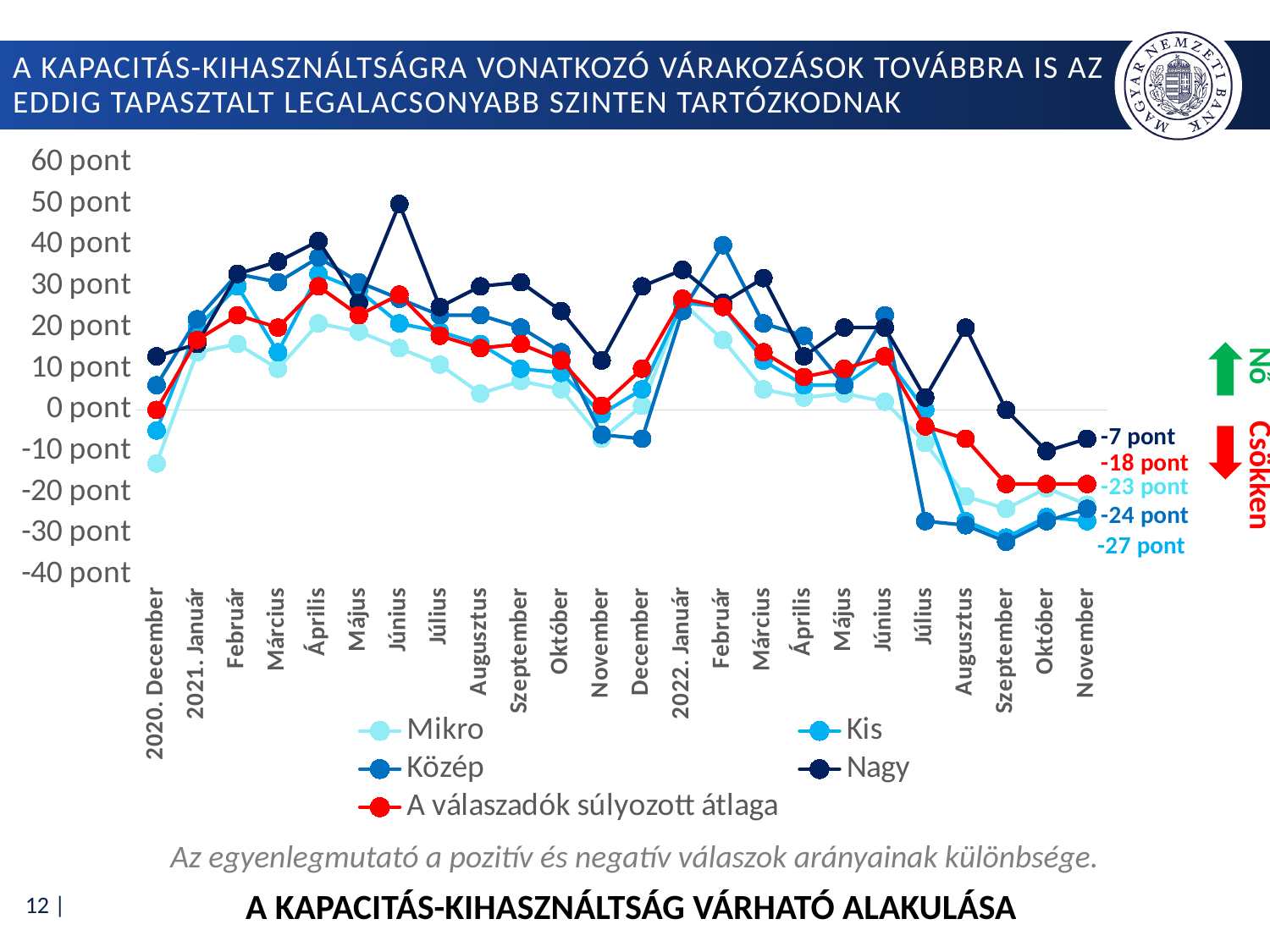
What is the value for Kis at the last point (November 2022)? -27 pont How many series does the legend list? 5 Which series has the lowest value at the last point (November 2022)? Kis What is the difference between the Nagy and Kis values at the last point (November 2022)? 20 pont How many time points are shown on the x axis? 24 What is the value for 'A válaszadók súlyozott átlaga' at the last point (November 2022)? -18 pont What is the value for Közép at the last point (November 2022)? -24 pont Which series has the highest value at the last point (November 2022)? Nagy What is the value for Mikro at the last point (November 2022)? -23 pont Is the value for Nagy in Június 2021 greater or less than 40 pont? greater What is the value for Nagy at the last point (November 2022)? -7 pont What kind of chart is shown on the slide? line chart